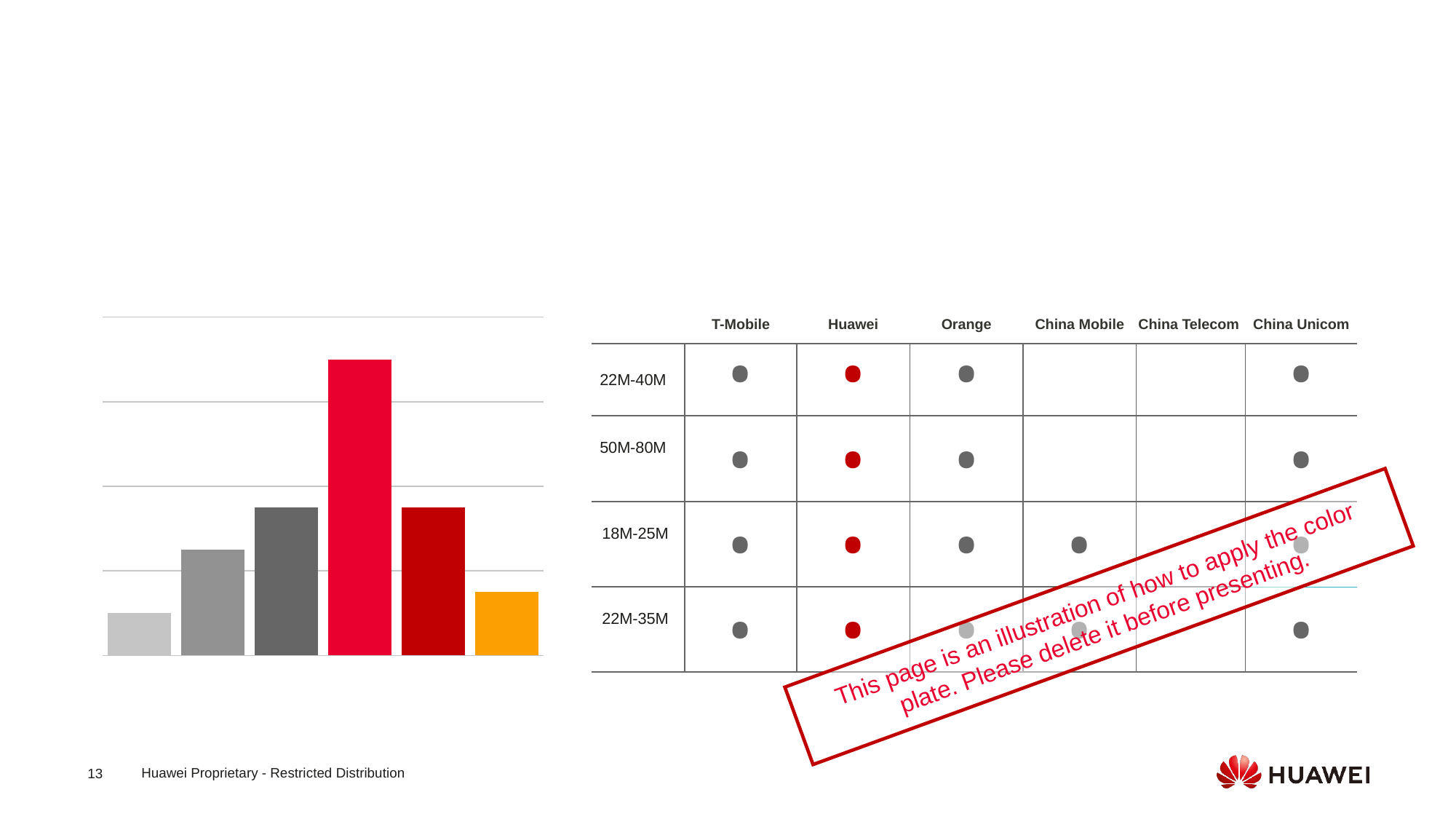
What kind of chart is shown on the left of the slide? Bar chart In the bar chart on the left, what colour is the tallest bar? Bright red In the bar chart on the left, is the third bar taller or shorter than the second bar? Taller In the bar chart on the left, do the bar heights rise steadily from left to right, or do they rise and then fall? Rise and then fall In the bar chart on the left, is the second bar taller or shorter than the sixth bar? Taller In the bar chart on the left, what colour is the rightmost bar? Orange In the bar chart on the left, which bar is the tallest, counting from the left? The fourth bar In the bar chart on the left, is the sixth bar taller or shorter than the fifth bar? Shorter In the bar chart on the left, which bar is the shortest, counting from the left? The first bar Does the bar chart on the left show any data labels or axis values? No How many bars does the bar chart on the left contain? 6